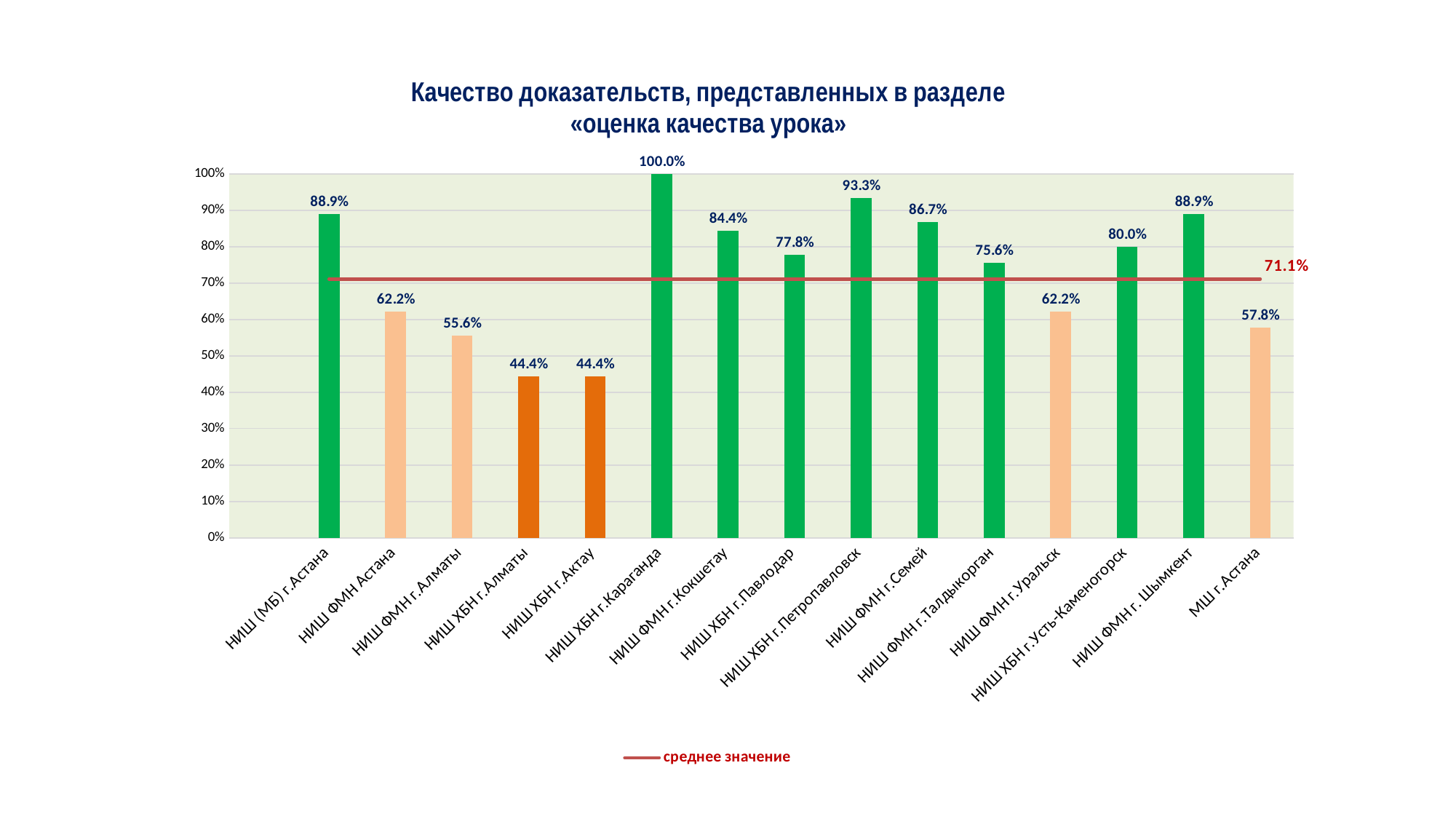
What is the difference between the values for НИШ ХБН г.Караганда and НИШ ФМН г.Семей? 13.3% How many entries does the legend list? 1 What is the lowest value shown on the chart? 44.4% Is the value for НИШ ФМН г.Алматы greater or less than 60%? less What kind of chart is shown on the slide? combination bar and line chart How many categories are shown on the x axis? 15 What is the value for НИШ ФМН г.Кокшетау? 84.4% Which category has the highest value? НИШ ХБН г.Караганда What is the value for МШ г.Астана? 57.8% What value is labelled on the red horizontal line (среднее значение)? 71.1% What is the value for НИШ ХБН г.Петропавловск? 93.3% Which is larger, the value for НИШ ХБН г.Павлодар or the value for НИШ ФМН г.Талдыкорган? НИШ ХБН г.Павлодар